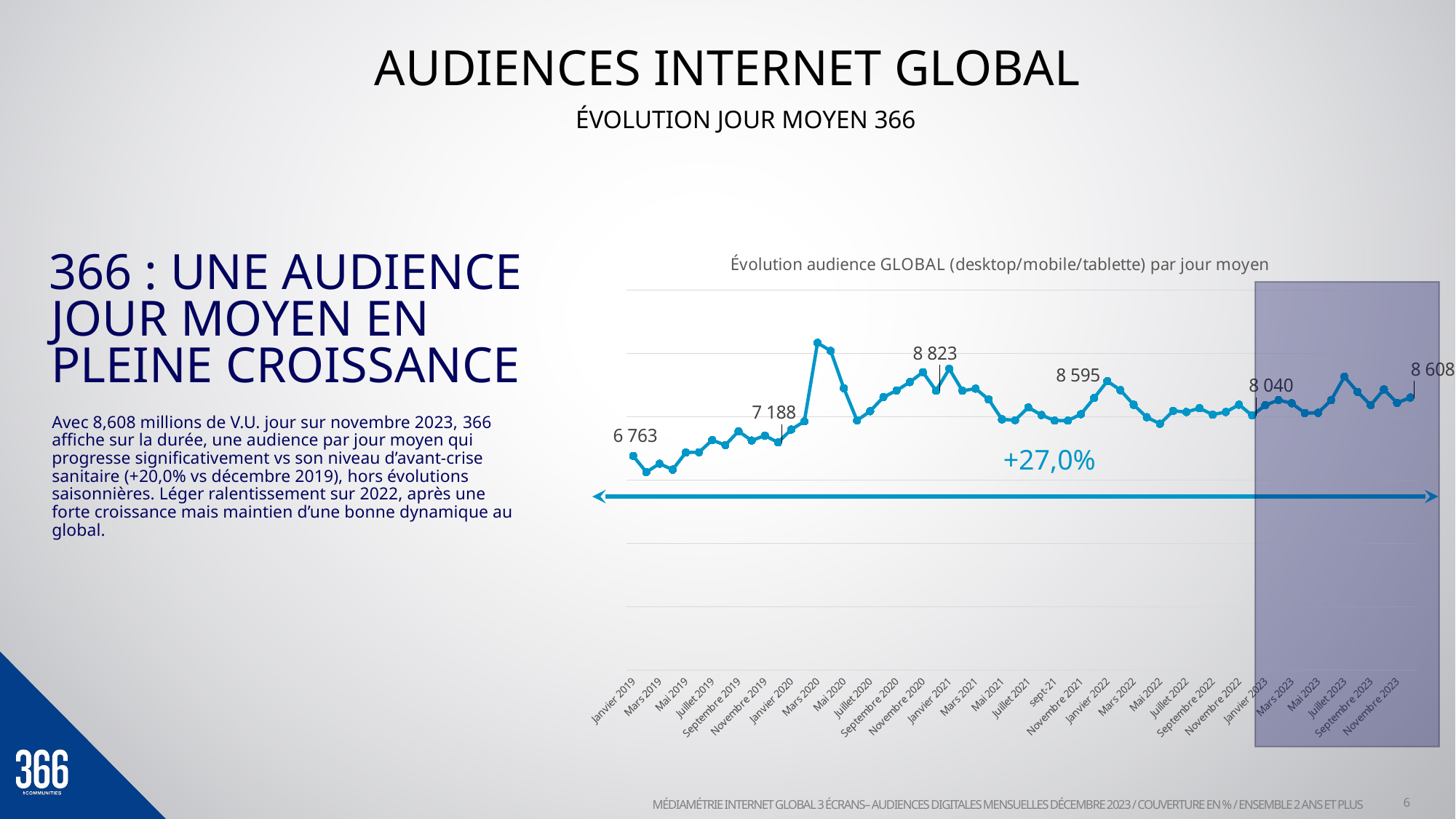
What is the value labelled for Novembre 2023? 8 608 In which month does the line reach its highest point? Mars 2020 What is the value labelled for Janvier 2019? 6 763 What type of chart is shown on the slide? line chart Overall, does the audience rise or fall from Janvier 2019 to Novembre 2023? rise What percentage change is annotated on the chart? +27,0%